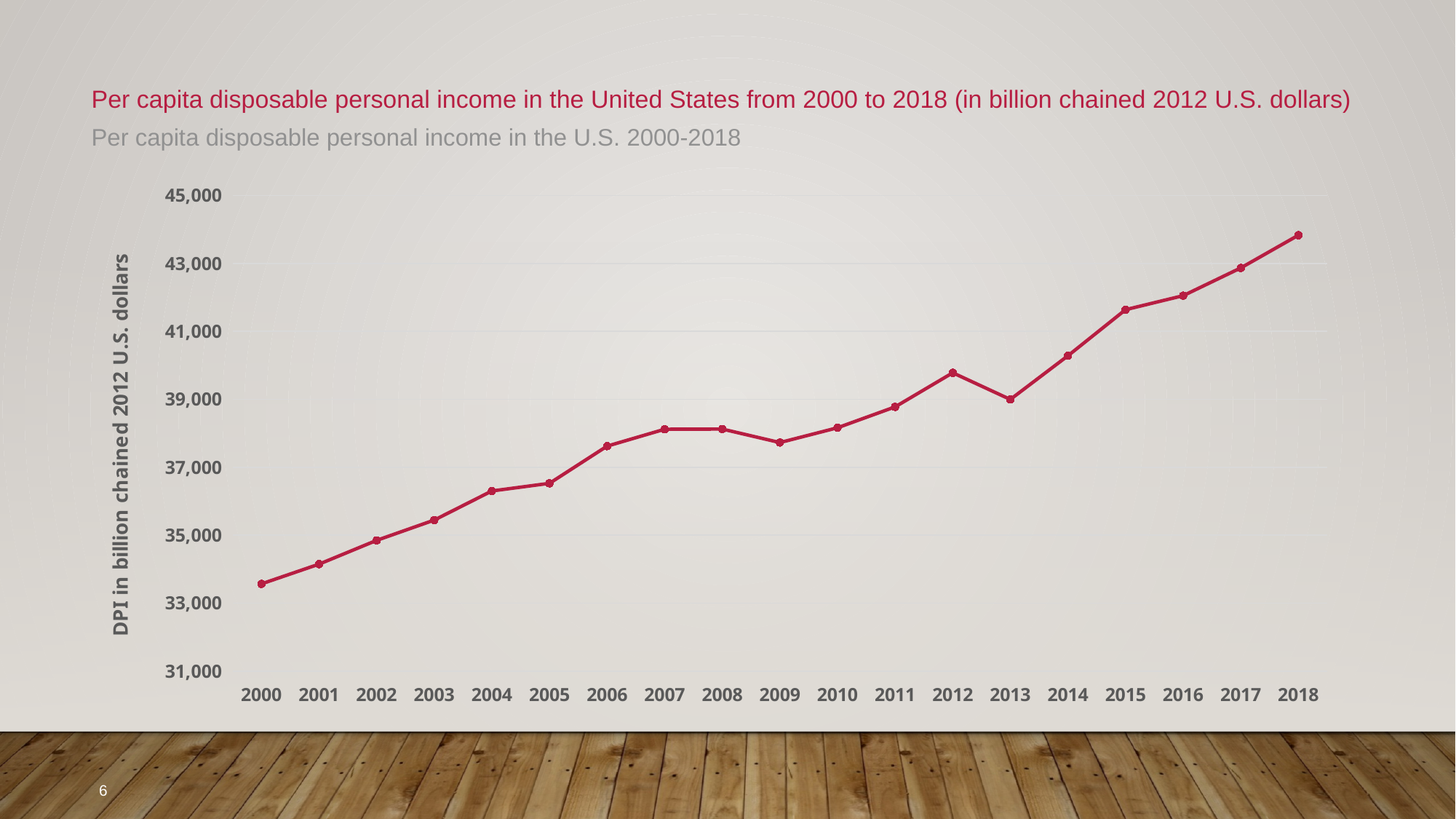
Which year has the larger value, 2012 or 2013? 2012 What kind of chart is shown on the slide? line chart Is the value for 2012 greater or less than 39,000? greater Is the value for 2005 greater or less than 37,000? less Overall, do the values rise or fall from 2000 to 2018? rise Which year has the highest per capita disposable personal income? 2018 Is the value for 2015 greater or less than 41,000? greater Which year has the lowest per capita disposable personal income? 2000 What is the title of the vertical axis? DPI in billion chained 2012 U.S. dollars How many years (data points) are plotted on the x axis? 19